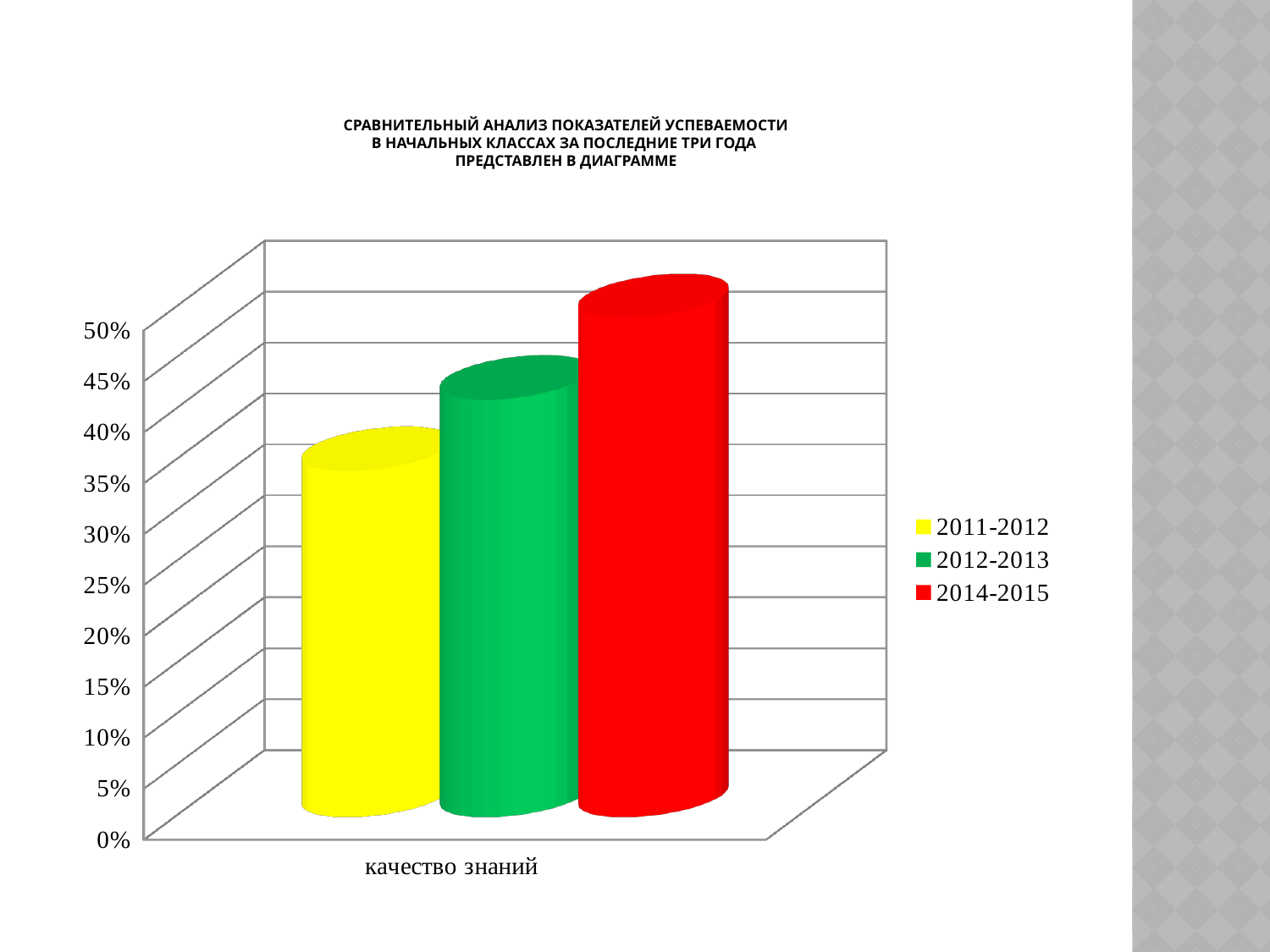
Is the value for 2014-2015 greater or less than 40%? greater Is the value for 2011-2012 greater or less than 25%? greater Which series has the lowest value for качество знаний? 2011-2012 Which is larger for качество знаний: the value for 2014-2015 or the value for 2012-2013? 2014-2015 Which series has the highest value for качество знаний? 2014-2015 What kind of chart is shown on the slide? bar chart What colour represents the 2014-2015 series in the legend? red Which is larger for качество знаний: the value for 2012-2013 or the value for 2011-2012? 2012-2013 How many series does the legend list? 3 Is the value for 2012-2013 greater or less than 30%? greater How many categories are shown on the x axis? 1 Do the values rise or fall from the 2011-2012 series to the 2014-2015 series? rise